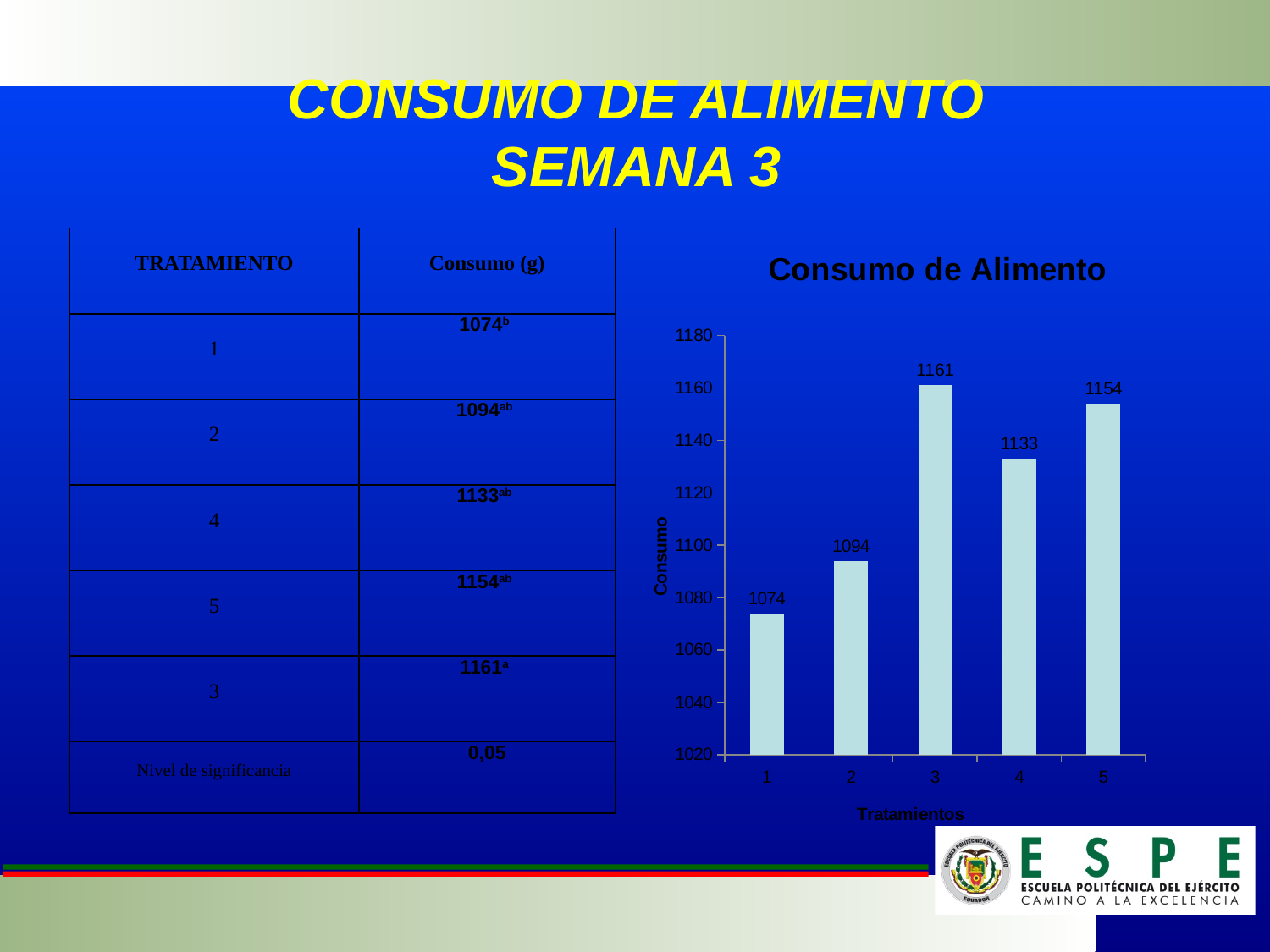
How many treatments are shown on the x axis of the chart? 5 What is the value for treatment 5 in the Consumo de Alimento chart? 1154 What is the value for treatment 3 in the Consumo de Alimento chart? 1161 Which treatment has the lowest consumption in the chart? 1 What is the value for treatment 1 in the Consumo de Alimento chart? 1074 Is the value for treatment 2 greater or less than 1100? less What is the difference between the values for treatment 4 and treatment 2? 39 What kind of chart is shown on the slide? bar chart Which treatment has the highest consumption in the chart? 3 What is the title of the chart on the slide? Consumo de Alimento What is the difference between the values for treatment 3 and treatment 1? 87 Which is larger, the value for treatment 2 or the value for treatment 4? treatment 4